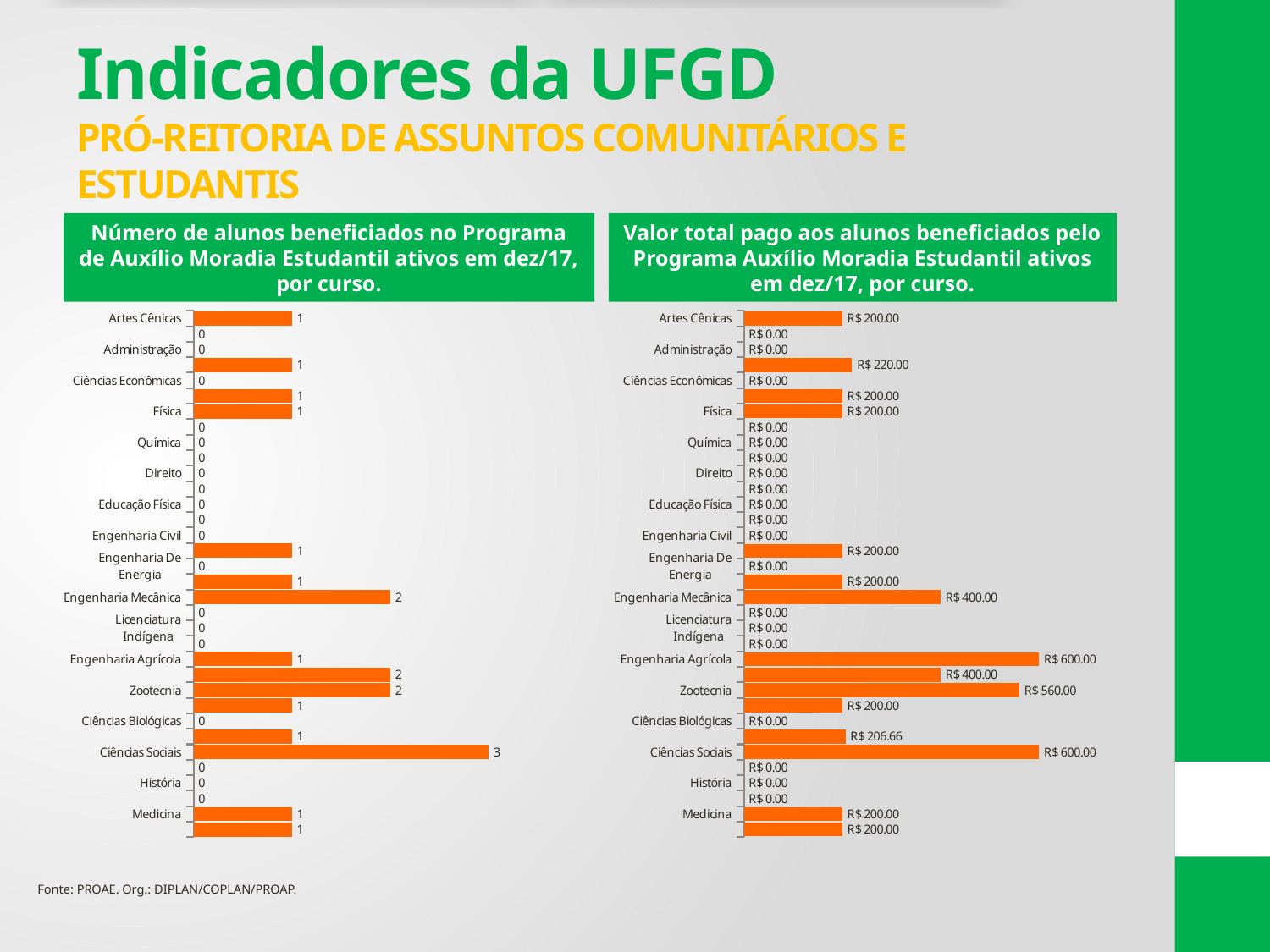
In the left chart (Número de alunos beneficiados), which course has the highest number of students? Ciências Sociais In the right chart (Valor total pago aos alunos beneficiados), what is the value for Artes Cênicas? R$ 200.00 In the left chart (Número de alunos beneficiados), what is the value for Engenharia Mecânica? 2 In the right chart (Valor total pago aos alunos beneficiados), which is larger: the value for Engenharia Mecânica or the value for Artes Cênicas? Engenharia Mecânica What kind of chart is the left chart, 'Número de alunos beneficiados no Programa de Auxílio Moradia Estudantil ativos em dez/17, por curso'? Bar chart In the left chart (Número de alunos beneficiados), what is the difference between Ciências Sociais and Engenharia Mecânica? 1 In the left chart (Número de alunos beneficiados), what is the value for Artes Cênicas? 1 In the right chart (Valor total pago aos alunos beneficiados), what is the value for Ciências Econômicas? R$ 0.00 In the right chart (Valor total pago aos alunos beneficiados), what is the highest value shown? R$ 600.00 In the right chart (Valor total pago aos alunos beneficiados), what is the value for Engenharia Mecânica? R$ 400.00 In the left chart (Número de alunos beneficiados), what is the value for Ciências Sociais? 3 What colour are the bars in both charts on the slide? Orange